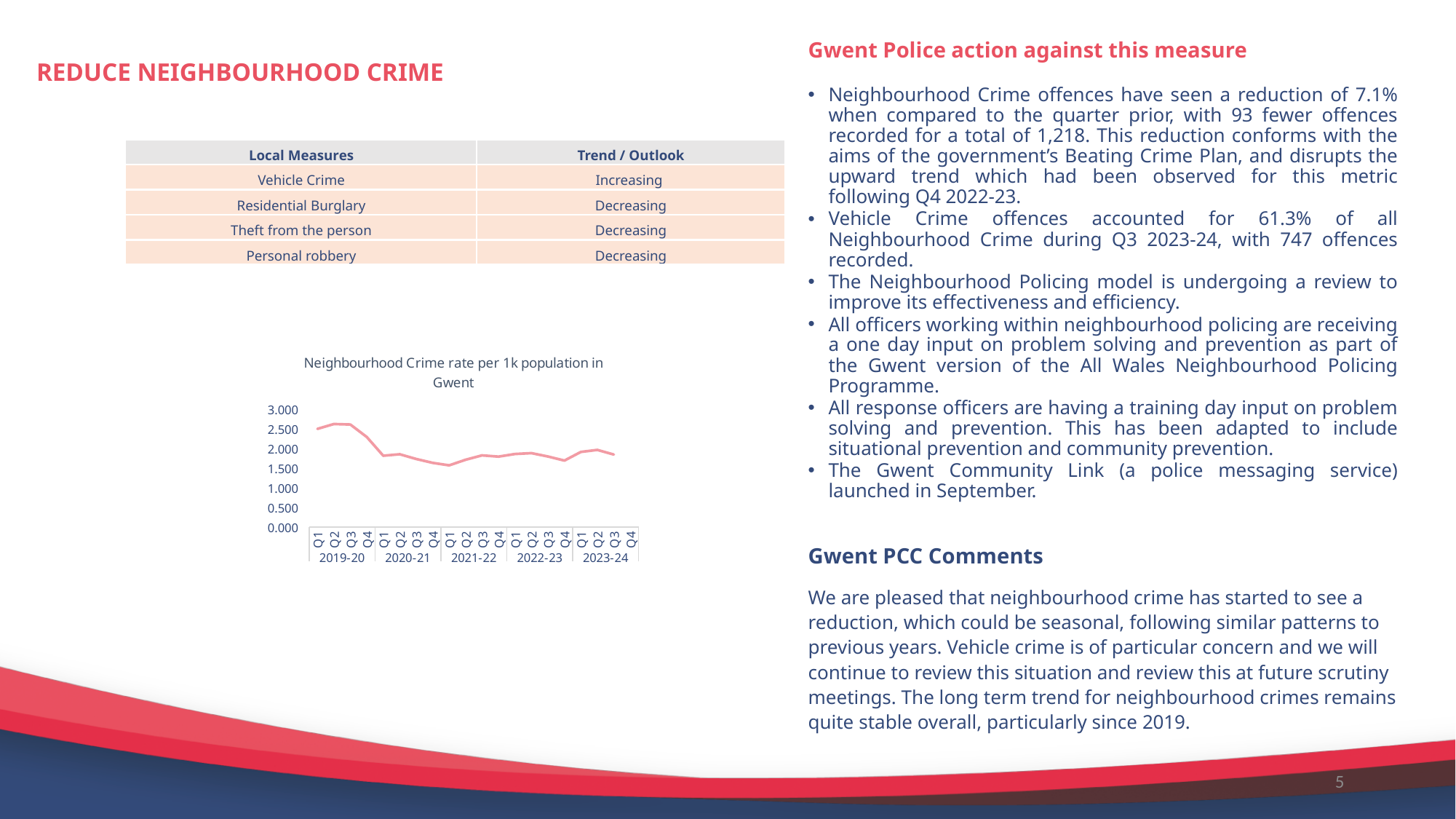
Is the value for Q1 2021-22 greater or less than 2.000? less Is the value for Q1 2020-21 greater or less than 2.000? less What is the title of the chart on the slide? Neighbourhood Crime rate per 1k population in Gwent Does the neighbourhood crime rate overall rise or fall from Q1 2019-20 to Q3 2023-24? Fall Is the value for Q1 2019-20 greater or less than 2.000? greater Which is larger, the value for Q1 2019-20 or the value for Q1 2020-21? Q1 2019-20 Which is larger, the value for Q2 2019-20 or the value for Q1 2021-22? Q2 2019-20 What is the highest value shown on the y axis of the chart? 3.000 How many financial years are labelled along the x axis of the chart? 5 What kind of chart is shown on the slide? Line chart In which financial year does the line reach its highest values? 2019-20